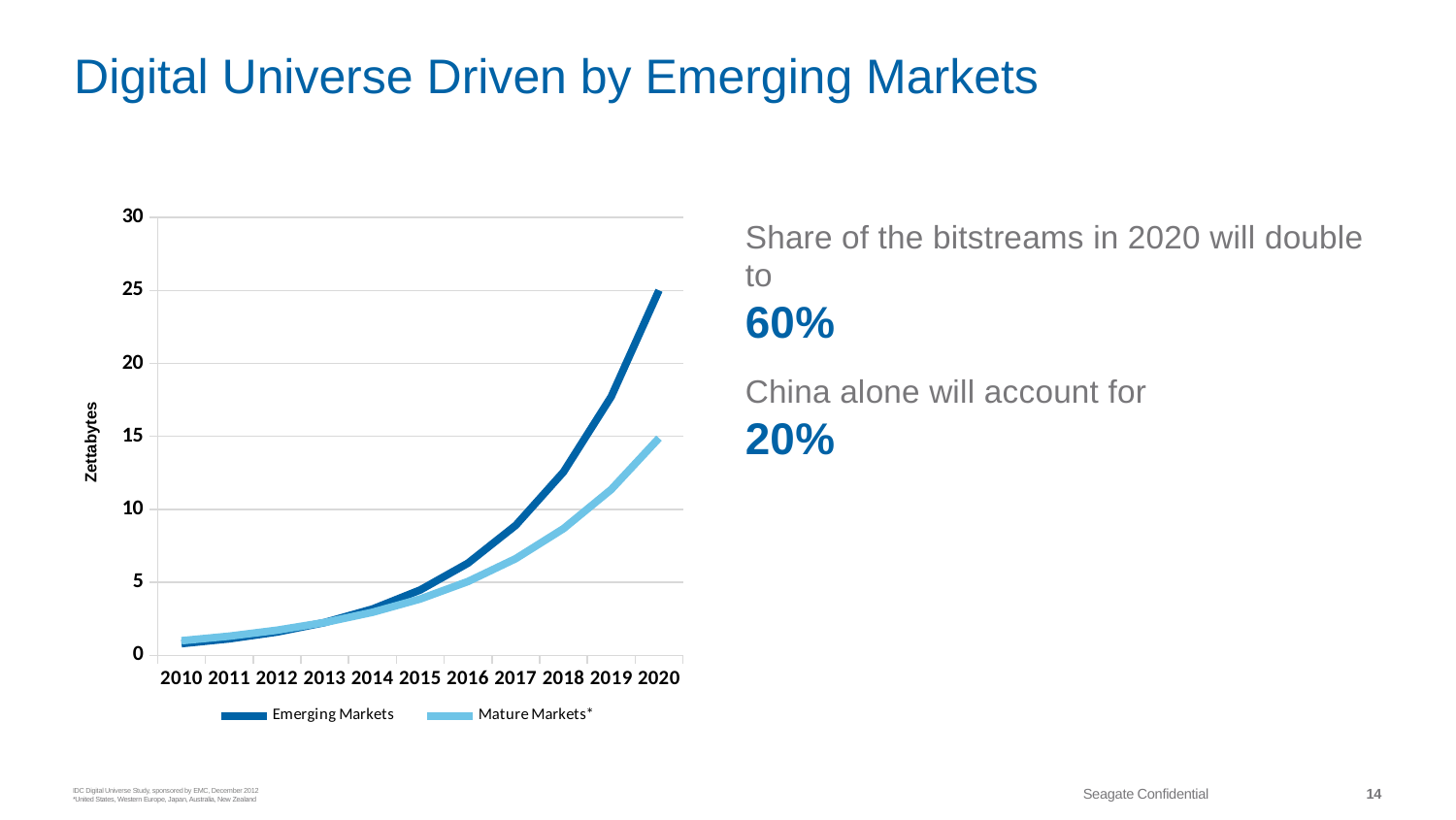
How many years are shown along the x axis of the chart? 11 Do the values for Emerging Markets rise or fall from 2010 to 2020? rise Is the value for Emerging Markets in 2018 greater or less than 10? greater What kind of chart is shown on the slide? line chart In 2020, which series has the larger value, Emerging Markets or Mature Markets*? Emerging Markets Is the value for Emerging Markets in 2014 greater or less than 5? less How many series does the chart's legend list? 2 Is the value for Mature Markets* in 2020 greater or less than 20? less What are the two series named in the chart's legend? Emerging Markets and Mature Markets* What is the label on the y axis of the chart? Zettabytes